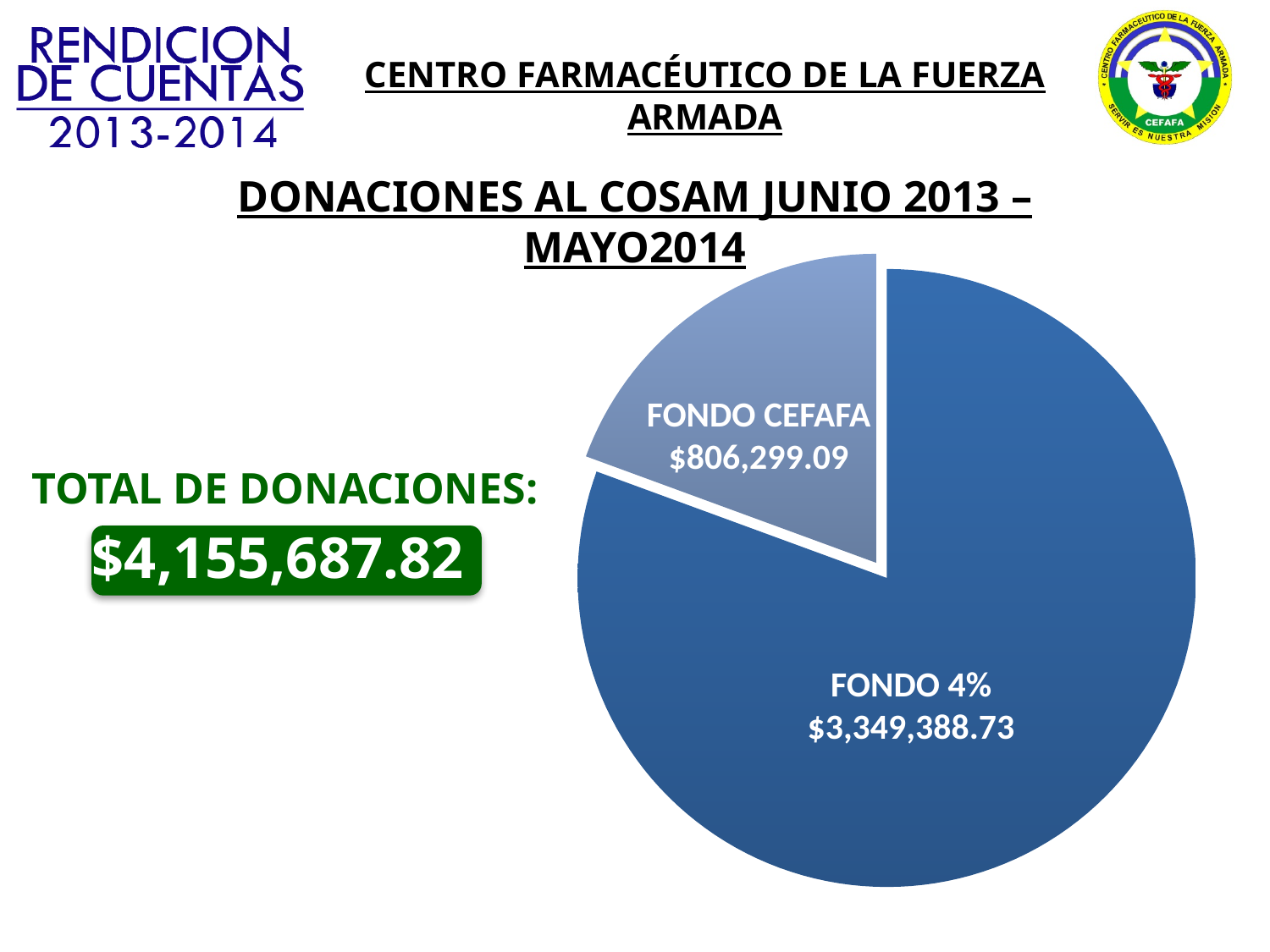
How many slices does the pie chart have? 2 What is the difference between the FONDO 4% value and the FONDO CEFAFA value? $2,543,089.64 Which slice of the pie chart is shown in the lighter blue colour? FONDO CEFAFA What is the total of all donations shown on the slide? $4,155,687.82 What is the value of the FONDO 4% slice? $3,349,388.73 What is the title of the pie chart? DONACIONES AL COSAM JUNIO 2013 – MAYO2014 What type of chart is shown on the slide? pie chart What is the value of the FONDO CEFAFA slice? $806,299.09 Which slice of the pie chart is the smallest? FONDO CEFAFA Which is larger, FONDO CEFAFA or FONDO 4%? FONDO 4% Which slice of the pie chart is the largest? FONDO 4%